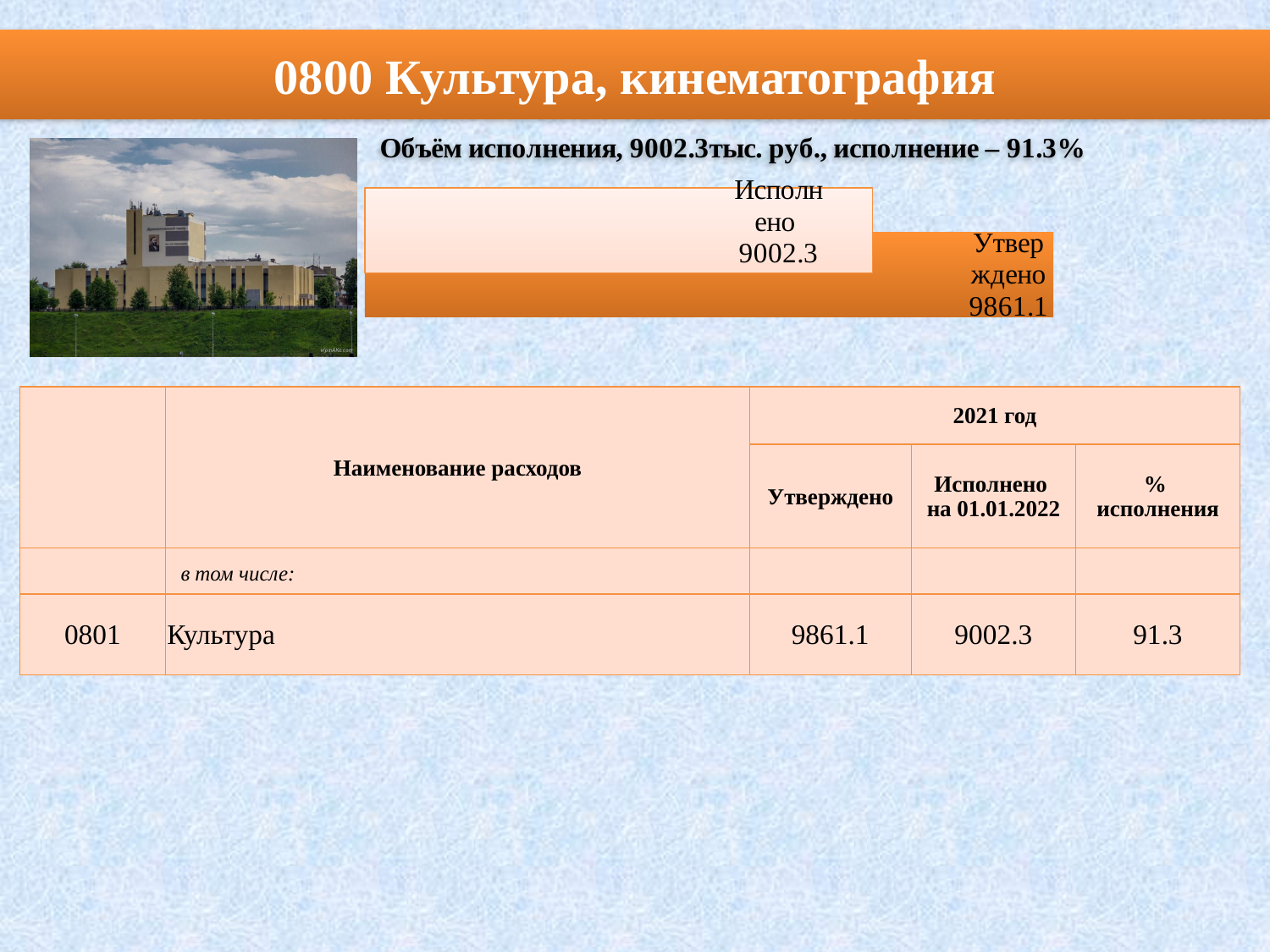
Are the bars in the chart horizontal or vertical? horizontal What is the value of the bar labelled Утверждено? 9861.1 What is the difference between the Утверждено and Исполнено values? 858.8 Which bar has the highest value? Утверждено Which bar has the higher value, Исполнено or Утверждено? Утверждено What colour is the Утверждено bar? orange How many bars are plotted in the chart? 2 What is the value of the bar labelled Исполнено? 9002.3 What kind of chart is shown on the slide? bar chart Which bar has the lowest value? Исполнено